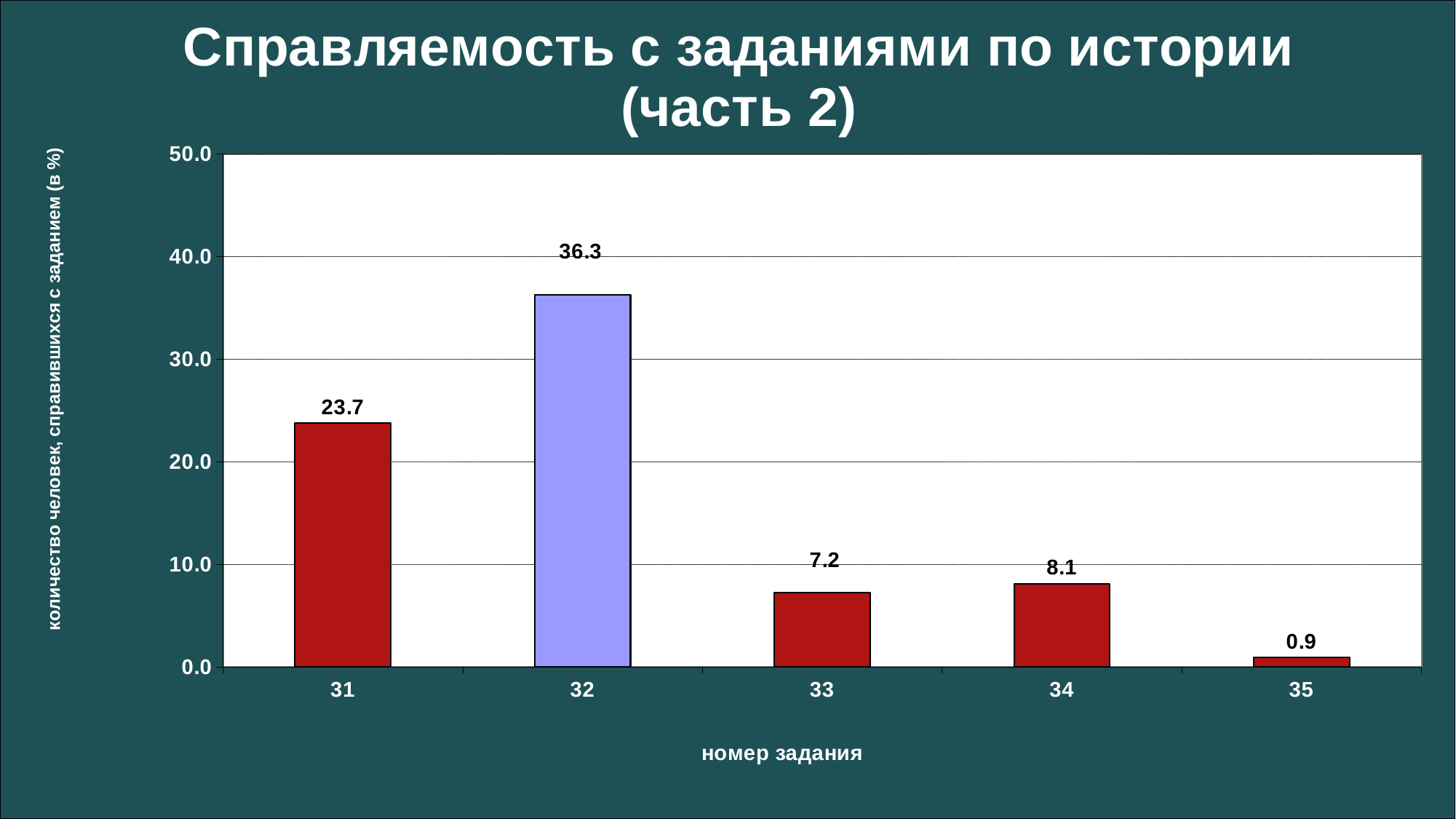
What kind of chart is shown on the slide? bar chart Is the value for task 31 greater or less than 20.0? greater What is the label of the x axis? номер задания How many task numbers are shown on the x axis? 5 What is the value for task 31? 23.7 Which task number has the highest value? 32 What is the difference between the values for task 34 and task 33? 0.9 What is the value for task 35? 0.9 Which has a larger value, task 33 or task 34? 34 What is the difference between the values for task 32 and task 31? 12.6 What is the value for task 32? 36.3 Which task number has the lowest value? 35